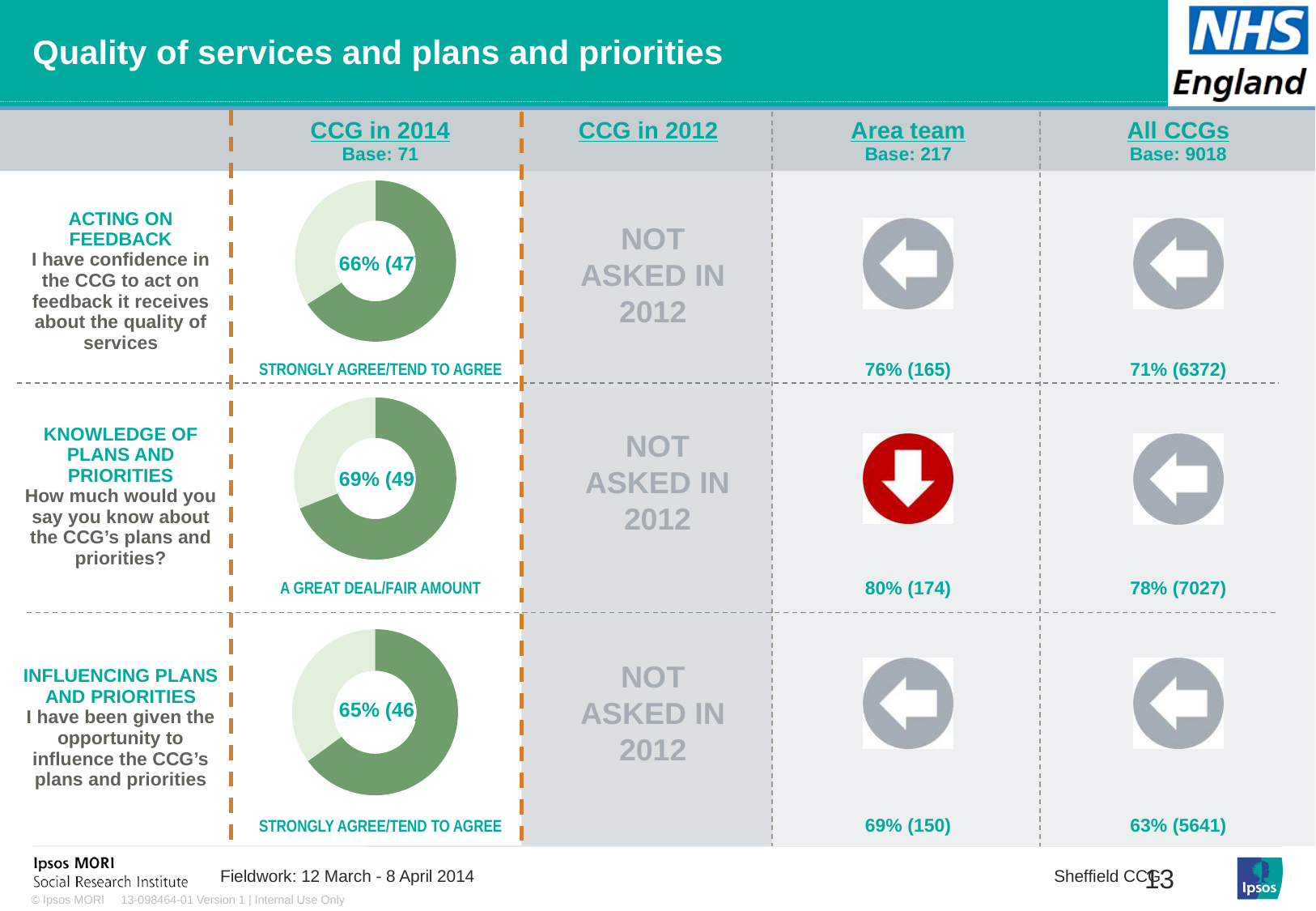
In the 'Knowledge of plans and priorities' donut chart (CCG in 2014), what value is shown? 69% (49) How many donut charts are shown on the slide? 3 Which donut chart shows a larger percentage: 'Acting on feedback' or 'Influencing plans and priorities'? Acting on feedback What kind of chart is used in the 'CCG in 2014' column for each of the three questions? Pie chart (donut) What is the base (number of respondents) for the 'CCG in 2014' donut charts? 71 Is the percentage shown in the 'Acting on feedback' donut chart greater or less than 50%? greater In the 'Influencing plans and priorities' donut chart (CCG in 2014), what value is shown? 65% (46) Which of the three donut charts in the 'CCG in 2014' column shows the lowest percentage? Influencing plans and priorities (65%) What label appears beneath the 'Knowledge of plans and priorities' donut chart? A GREAT DEAL/FAIR AMOUNT In the 'Acting on feedback' donut chart (CCG in 2014), what value is shown? 66% (47) Which of the three donut charts in the 'CCG in 2014' column shows the highest percentage? Knowledge of plans and priorities (69%) What is the difference in percentage points between the 'Knowledge of plans and priorities' donut (69%) and the 'Influencing plans and priorities' donut (65%)? 4 percentage points